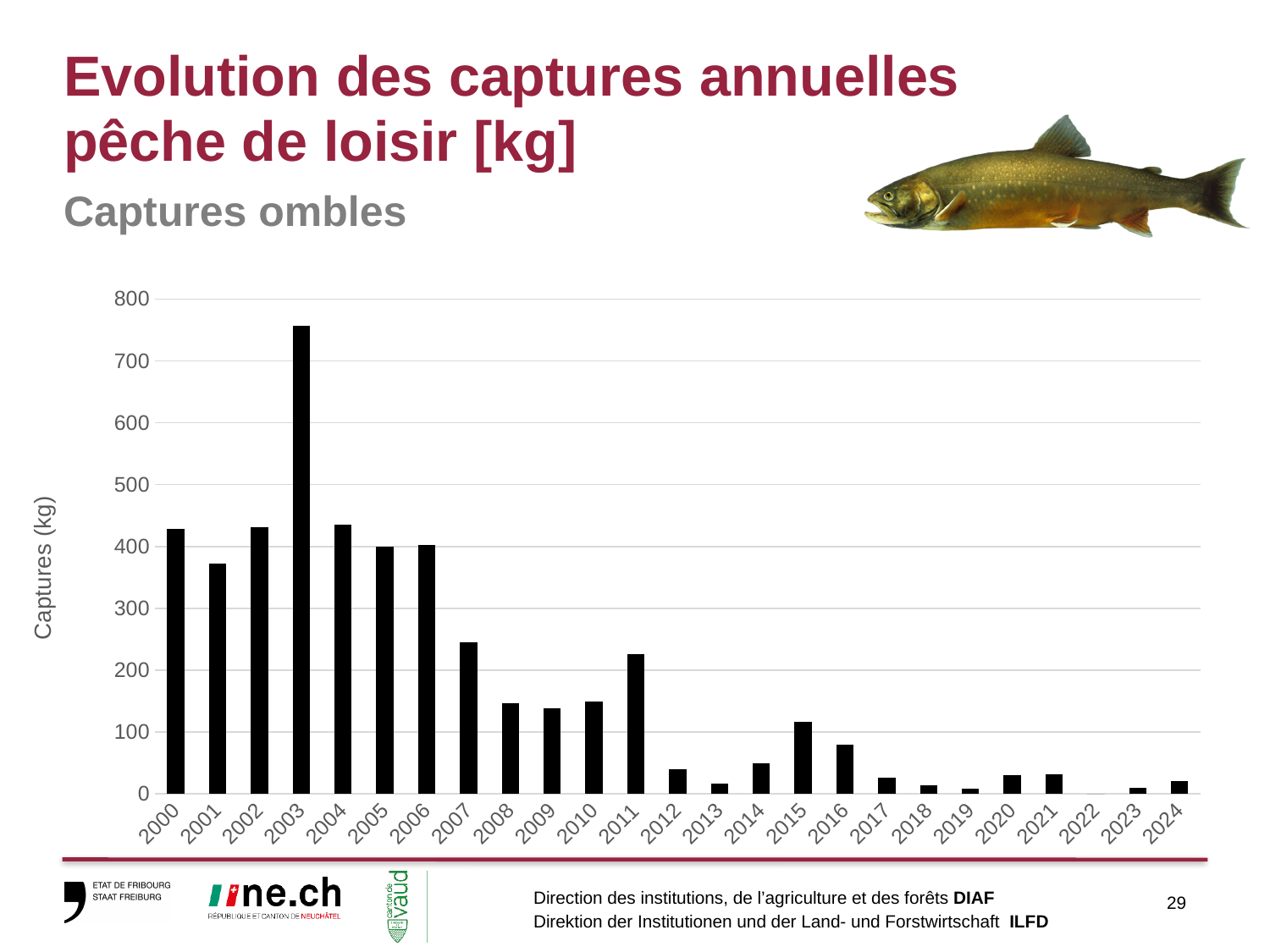
Which is larger, the value for 2007 or the value for 2011? 2007 Is the value for 2003 greater or less than 700? greater Is the value for 2000 greater or less than 400? greater Is the value for 2007 greater or less than 300? less How many years are shown on the x axis? 25 Which year has the highest value for captures? 2003 What kind of chart is shown on the slide? Bar chart What is the label of the y axis? Captures (kg) Overall, do the captures rise or fall from 2000 to 2024? fall